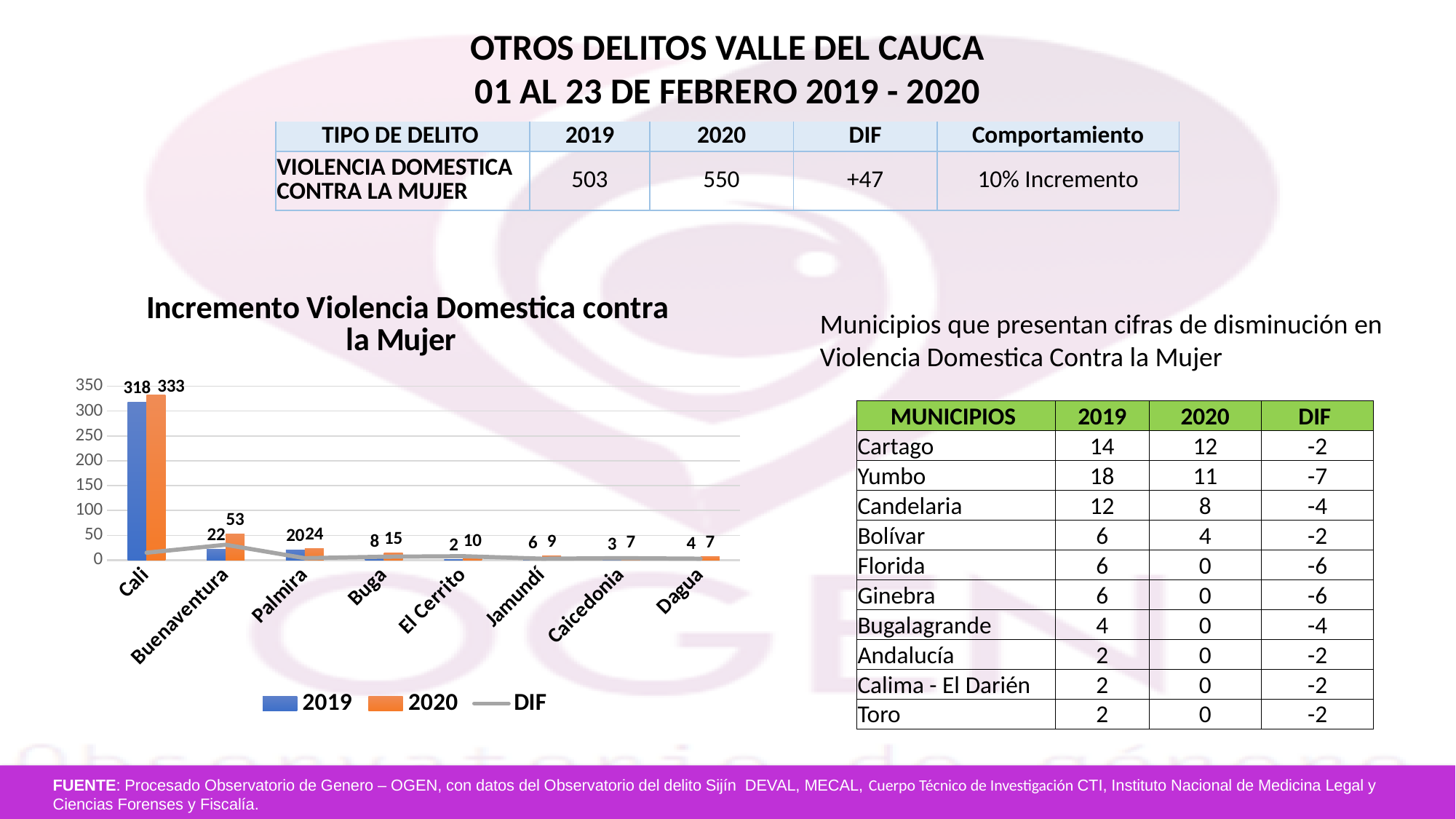
In the chart 'Incremento Violencia Domestica contra la Mujer', which municipality has the highest 2020 value? Cali In the chart 'Incremento Violencia Domestica contra la Mujer', what is the difference between the 2020 and 2019 values for Cali? 15 In the chart 'Incremento Violencia Domestica contra la Mujer', what is the 2019 value for Buenaventura? 22 In the chart 'Incremento Violencia Domestica contra la Mujer', is the 2019 value for Cali greater or less than 300? greater In the chart 'Incremento Violencia Domestica contra la Mujer', which is larger: the 2020 value for Palmira or the 2020 value for Buga? Palmira In the chart 'Incremento Violencia Domestica contra la Mujer', which municipality has the lowest 2019 value? El Cerrito How many municipalities are shown on the x axis of the chart 'Incremento Violencia Domestica contra la Mujer'? 8 In the chart 'Incremento Violencia Domestica contra la Mujer', which colour represents the 2020 series? Orange In the chart 'Incremento Violencia Domestica contra la Mujer', what is the difference between the 2020 and 2019 values for Buenaventura? 31 In the chart 'Incremento Violencia Domestica contra la Mujer', what is the 2020 value for Cali? 333 In the chart 'Incremento Violencia Domestica contra la Mujer', what is the 2020 value for El Cerrito? 10 How many series does the legend of the chart 'Incremento Violencia Domestica contra la Mujer' list? 3